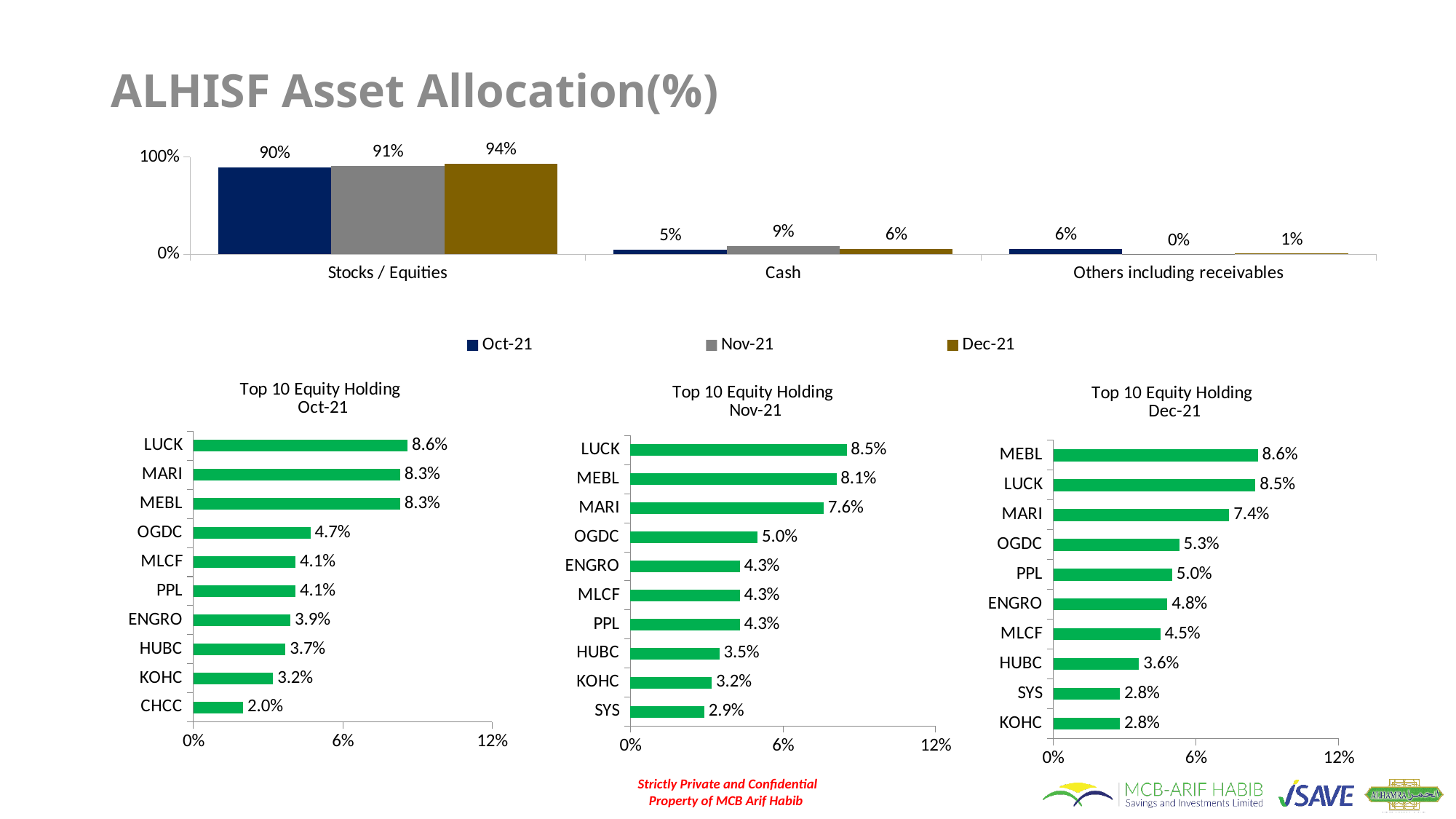
In the ALHISF Asset Allocation chart, what is the difference between the Stocks / Equities values for Dec-21 and Oct-21? 4% What kind of chart is the Top 10 Equity Holding Dec-21 chart? Bar chart In the Top 10 Equity Holding Dec-21 chart, which holding has the highest value? MEBL In the ALHISF Asset Allocation chart, how many series does the legend list? 3 In the ALHISF Asset Allocation chart, which month has the lowest value for Others including receivables? Nov-21 In the Top 10 Equity Holding Nov-21 chart, what is the difference between LUCK and MEBL? 0.4% In the Top 10 Equity Holding Oct-21 chart, what is the value for OGDC? 4.7% In the ALHISF Asset Allocation chart, what is the value for Stocks / Equities in Dec-21? 94% In the Top 10 Equity Holding Oct-21 chart, which holding has the lowest value? CHCC In the Top 10 Equity Holding Nov-21 chart, what is the value for MARI? 7.6% In the ALHISF Asset Allocation chart, what is the value for Cash in Nov-21? 9% In the Top 10 Equity Holding Dec-21 chart, which is larger, OGDC or PPL? OGDC